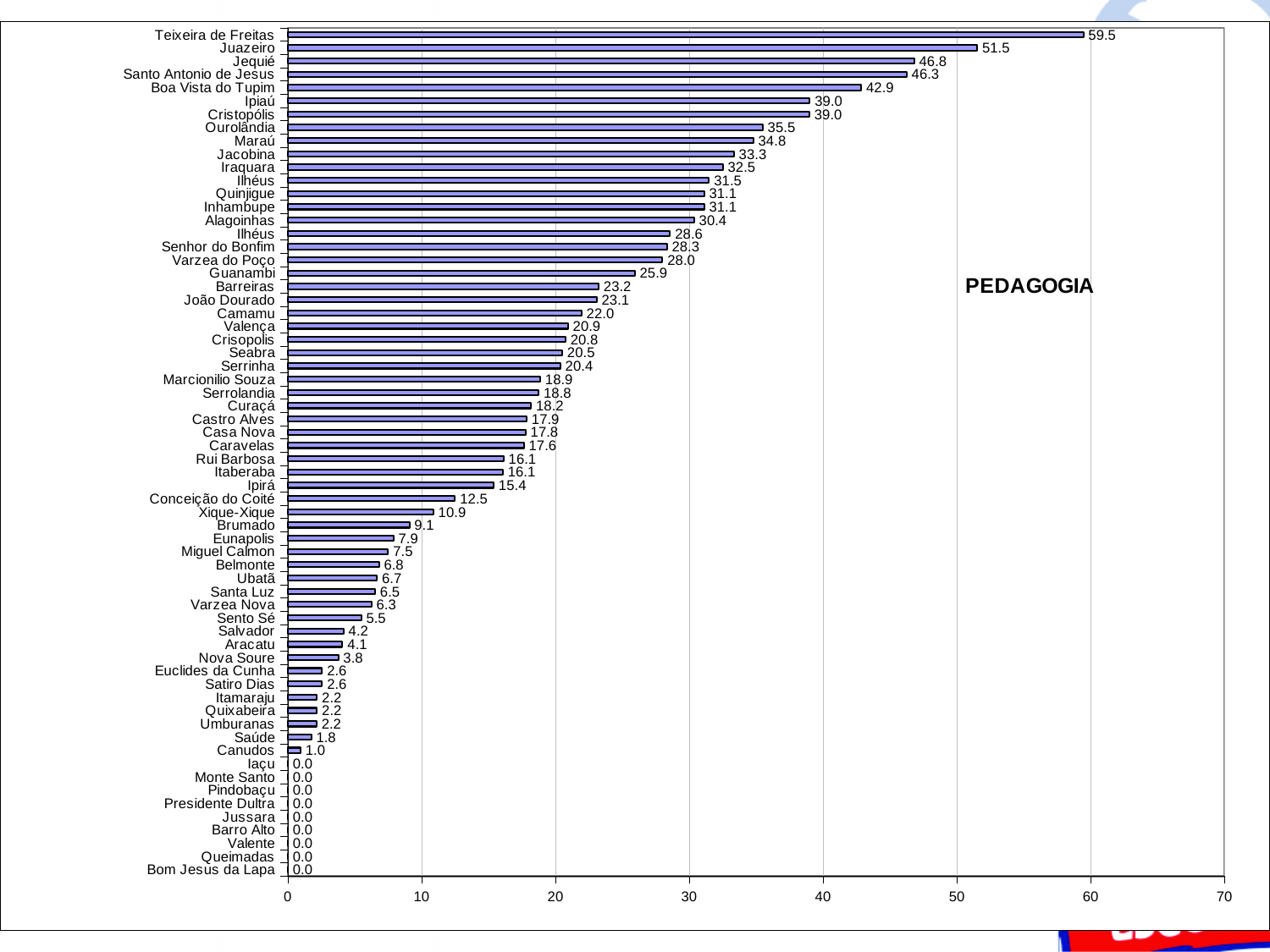
What kind of chart is shown on the slide? bar chart Is the value for Boa Vista do Tupim greater or less than 40? greater What is the difference between the values for Juazeiro and Jequié? 4.7 What is the title shown on the chart? PEDAGOGIA What is the value for Salvador? 4.2 Which category has the highest value? Teixeira de Freitas What is the value for Teixeira de Freitas? 59.5 What is the value for Xique-Xique? 10.9 Which is larger, the value for Guanambi or the value for Camamu? Guanambi What is the difference between the values for Barreiras and Brumado? 14.1 What is the value for Jacobina? 33.3 How many categories have a value of 0.0? 9